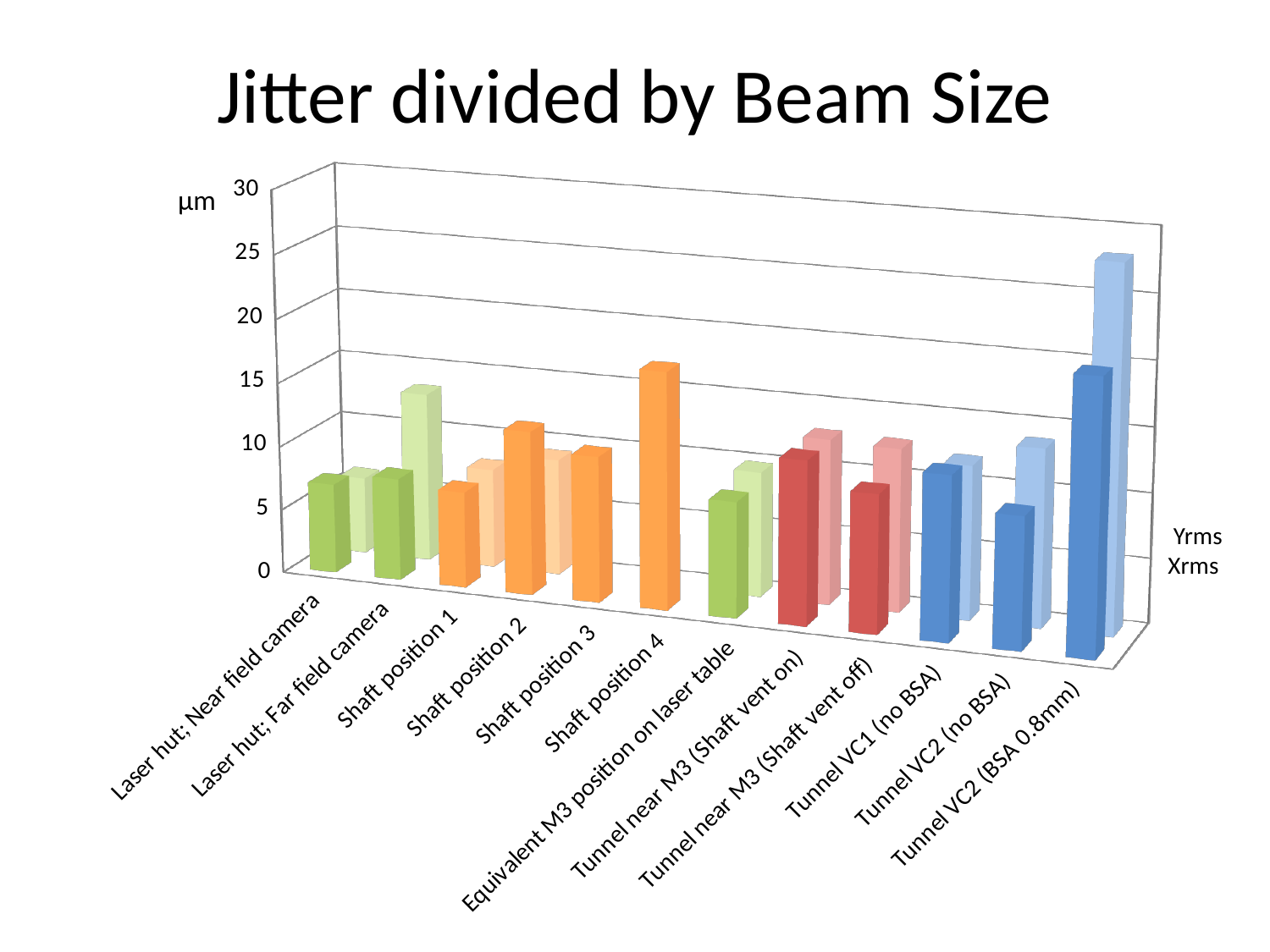
Is the Xrms value for Shaft position 4 greater or less than 10? greater Is the Yrms value for Tunnel VC2 (BSA 0.8mm) greater or less than 20? greater How many categories are listed along the x axis of the chart? 12 Which category has the highest Yrms value? Tunnel VC2 (BSA 0.8mm) For Laser hut; Far field camera, which is larger, Xrms or Yrms? Yrms For Shaft position 2, which is larger, Xrms or Yrms? Xrms What kind of chart is shown on the slide? bar chart What is the title of the chart? Jitter divided by Beam Size Is the Xrms value for Laser hut; Near field camera greater or less than 10? less What unit is shown on the vertical axis of the chart? µm How many series does the chart show? 2